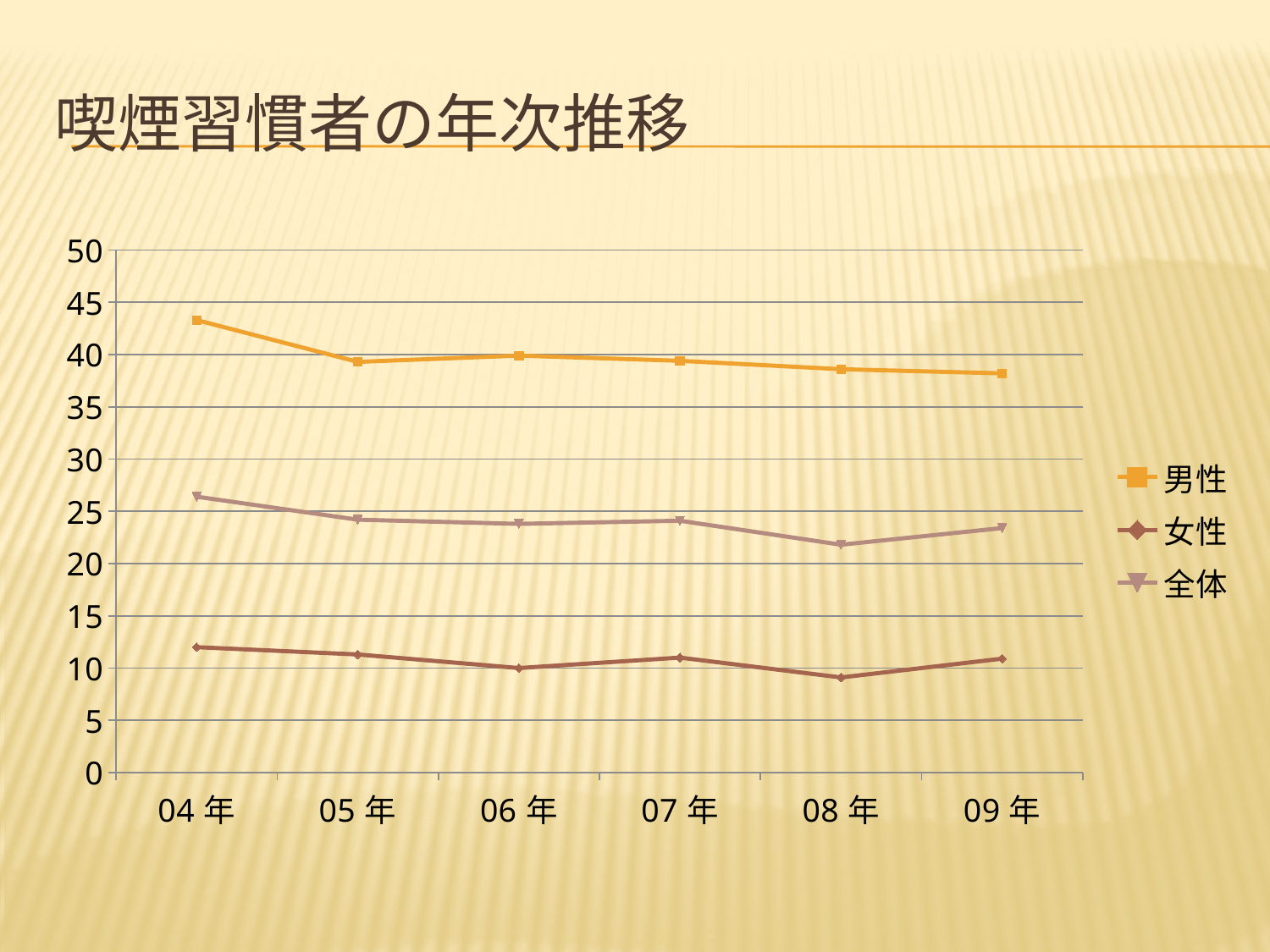
Is the value for 女性 in 04年 greater or less than 10? greater Is the value for 男性 in 09年 greater or less than 40? less Is the value for 男性 in 04年 greater or less than 40? greater What is the title of the chart? 喫煙習慣者の年次推移 What kind of chart is shown on the slide? line chart In which year is the value for 全体 lowest? 08年 How many years are plotted along the x axis? 6 Which series is shown with the orange line and square markers? 男性 In which year is the value for 男性 highest? 04年 Which series has the higher value in 07年, 男性 or 女性? 男性 How many series does the legend list? 3